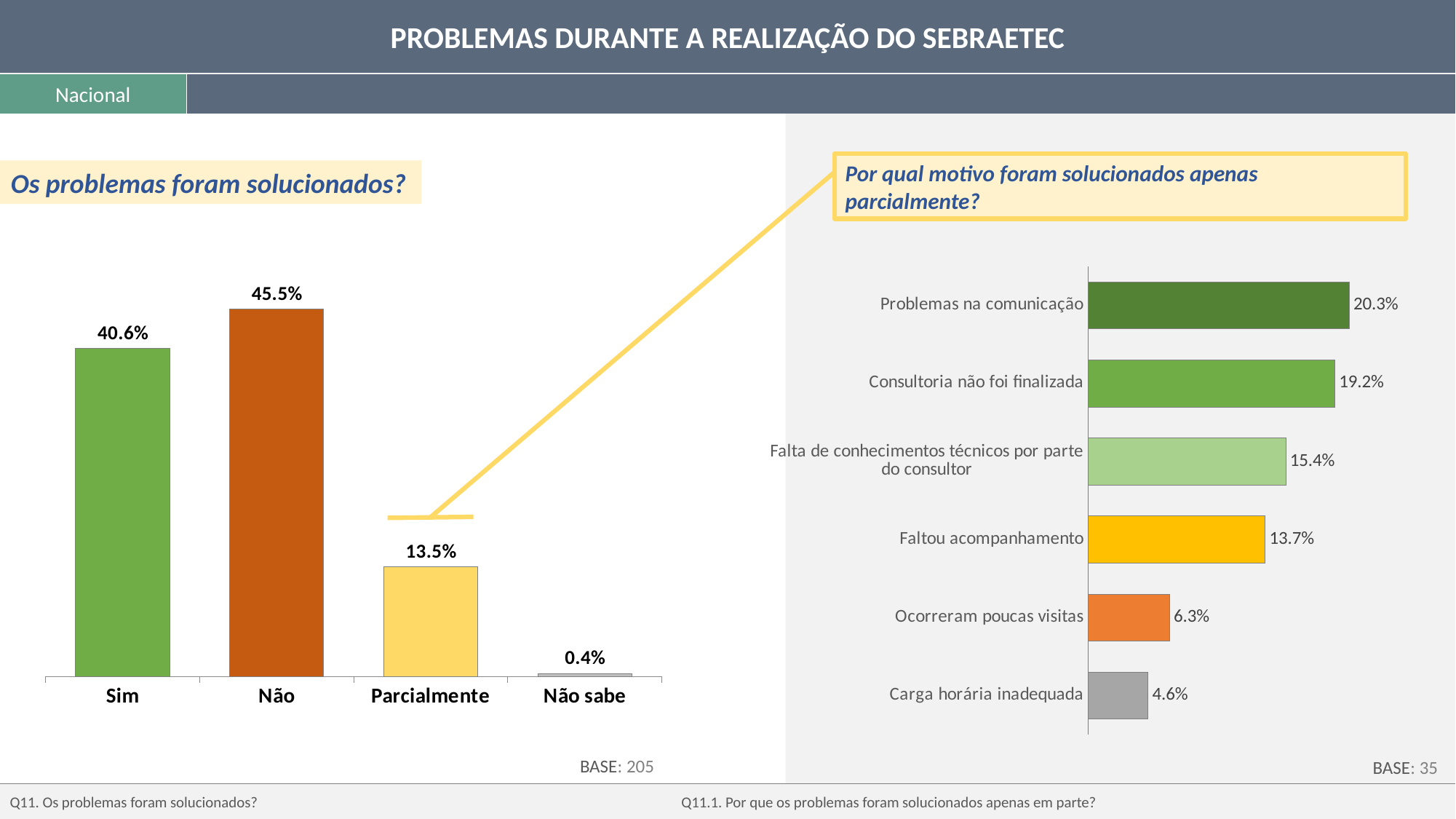
In the right chart 'Por qual motivo foram solucionados apenas parcialmente?', what is the value for 'Faltou acompanhamento'? 13.7% In the left chart 'Os problemas foram solucionados?', which category has the lowest value? Não sabe In the left chart 'Os problemas foram solucionados?', what is the value for 'Não'? 45.5% In the right chart 'Por qual motivo foram solucionados apenas parcialmente?', how many categories are shown? 6 In the left chart 'Os problemas foram solucionados?', which category has the highest value? Não In the left chart 'Os problemas foram solucionados?', what is the value for 'Parcialmente'? 13.5% In the left chart 'Os problemas foram solucionados?', what is the difference between 'Não' and 'Sim'? 4.9% In the right chart 'Por qual motivo foram solucionados apenas parcialmente?', which is larger: 'Consultoria não foi finalizada' or 'Falta de conhecimentos técnicos por parte do consultor'? Consultoria não foi finalizada What kind of chart is the right chart 'Por qual motivo foram solucionados apenas parcialmente?'? Bar chart In the left chart 'Os problemas foram solucionados?', how many categories are shown? 4 In the right chart 'Por qual motivo foram solucionados apenas parcialmente?', which category has the highest value? Problemas na comunicação In the right chart 'Por qual motivo foram solucionados apenas parcialmente?', what is the value for 'Carga horária inadequada'? 4.6%